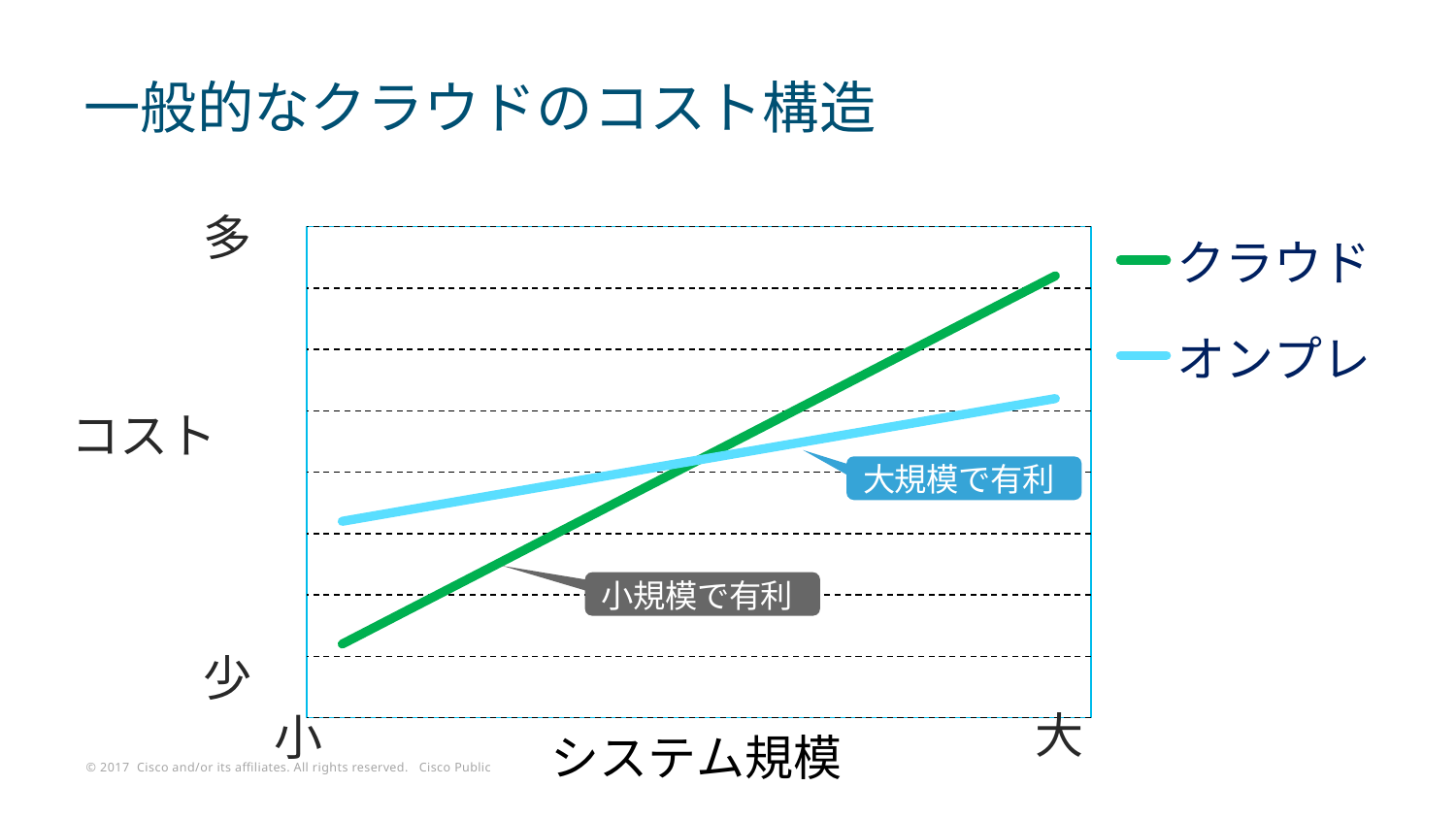
Does the cost for オンプレ rise or fall as システム規模 increases from 小 to 大? rise Which series is drawn in green? クラウド Which series is labelled with the annotation 小規模で有利? クラウド At the large end of システム規模 (大), which series has the higher cost, クラウド or オンプレ? クラウド At the small end of システム規模 (小), which series has the higher cost, クラウド or オンプレ? オンプレ How many series does the legend list? 2 What kind of chart is shown on the slide? line chart What is the title of the chart on the slide? 一般的なクラウドのコスト構造 Does the cost for クラウド rise or fall as システム規模 increases from 小 to 大? rise